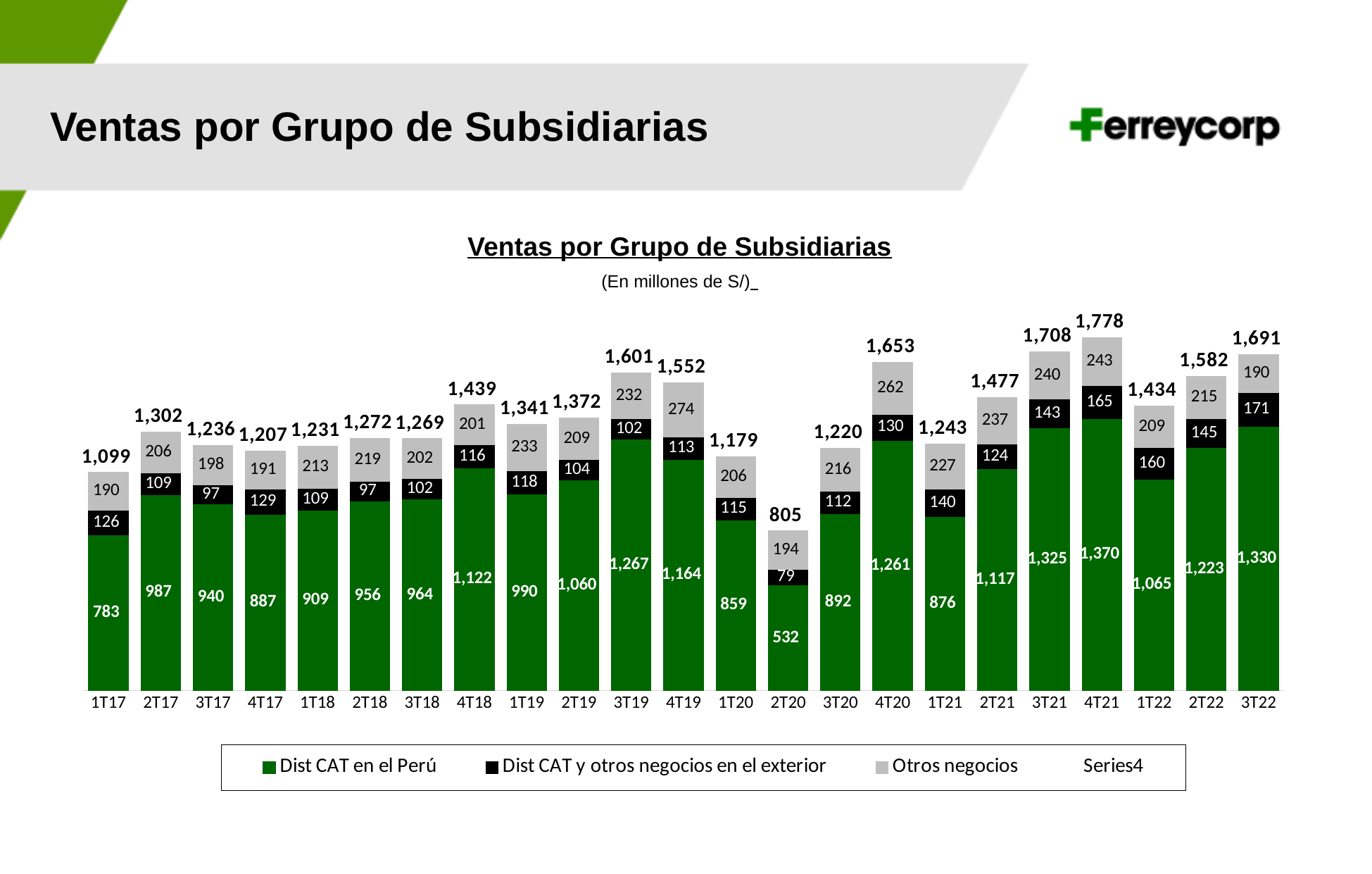
What is the value of Dist CAT y otros negocios en el exterior for 4T21? 165 What is the value of Otros negocios for 4T19? 274 What is the difference between the total for 4T21 and the total for 3T21? 70 What is the total of the stacked bar for 2T22? 1,582 Which quarter has the lowest total sales? 2T20 Do the total sales rise or fall from 2T20 to 4T20? Rise Which quarter has the larger Otros negocios value, 3T19 or 4T19? 4T19 How many quarters (categories) are shown on the x axis of the chart? 23 What kind of chart is shown on the slide? Stacked bar chart What is the value of Dist CAT en el Perú for 3T19? 1,267 Which quarter has the highest total sales? 4T21 How many series does the chart's legend list? 4